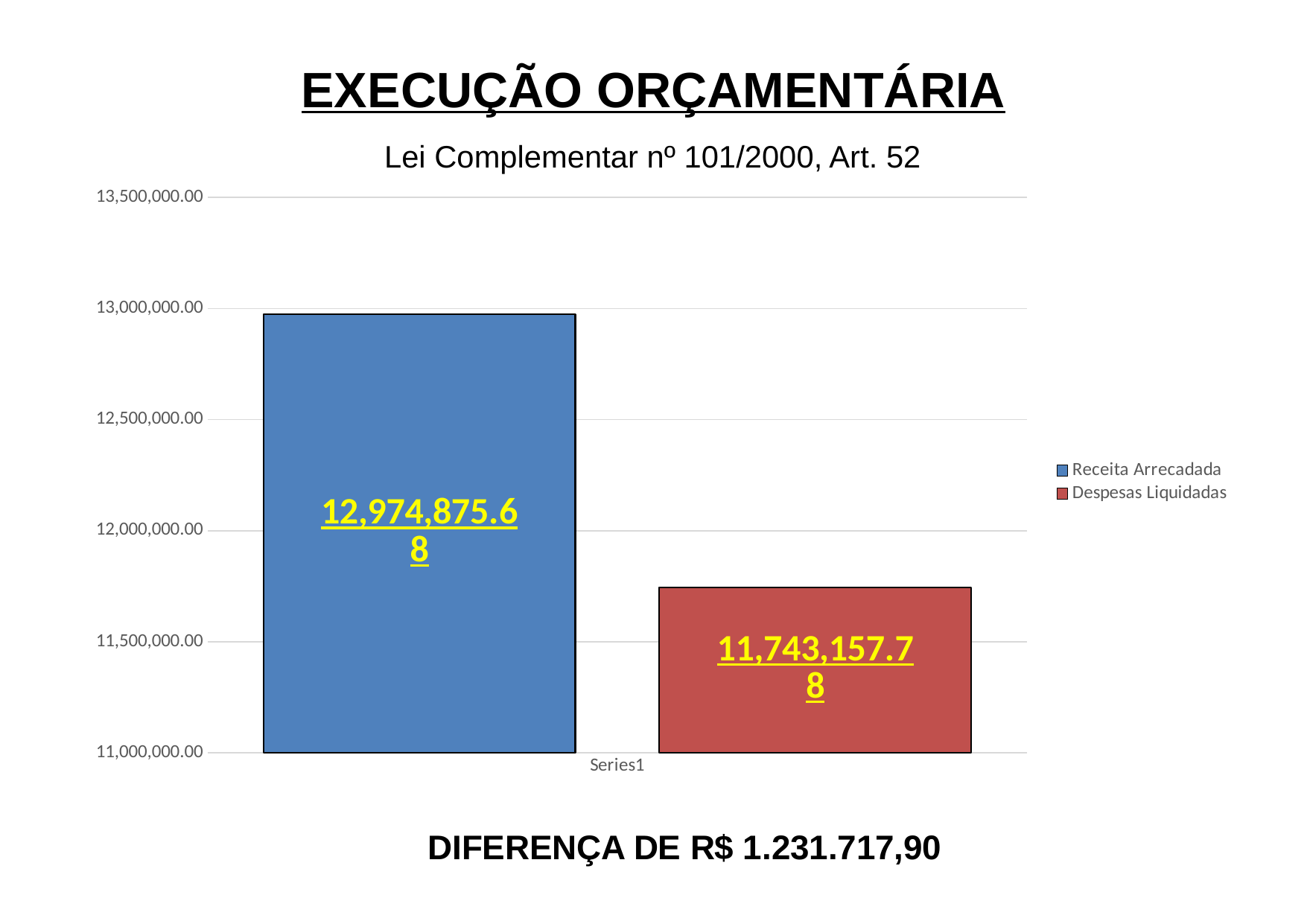
What is the title of the slide? EXECUÇÃO ORÇAMENTÁRIA How many series does the legend list? 2 Is the value for Despesas Liquidadas greater or less than 12,000,000.00? less Which series has the higher value, Receita Arrecadada or Despesas Liquidadas? Receita Arrecadada What is the difference between Receita Arrecadada and Despesas Liquidadas? 1,231,717.90 What is the category label shown on the x axis? Series1 What is the value for Despesas Liquidadas? 11,743,157.78 What colour is the bar for Despesas Liquidadas? Red What is the value for Receita Arrecadada? 12,974,875.68 What kind of chart is shown on the slide? Bar chart Is the value for Receita Arrecadada greater or less than 12,500,000.00? greater Which series has the lowest value? Despesas Liquidadas